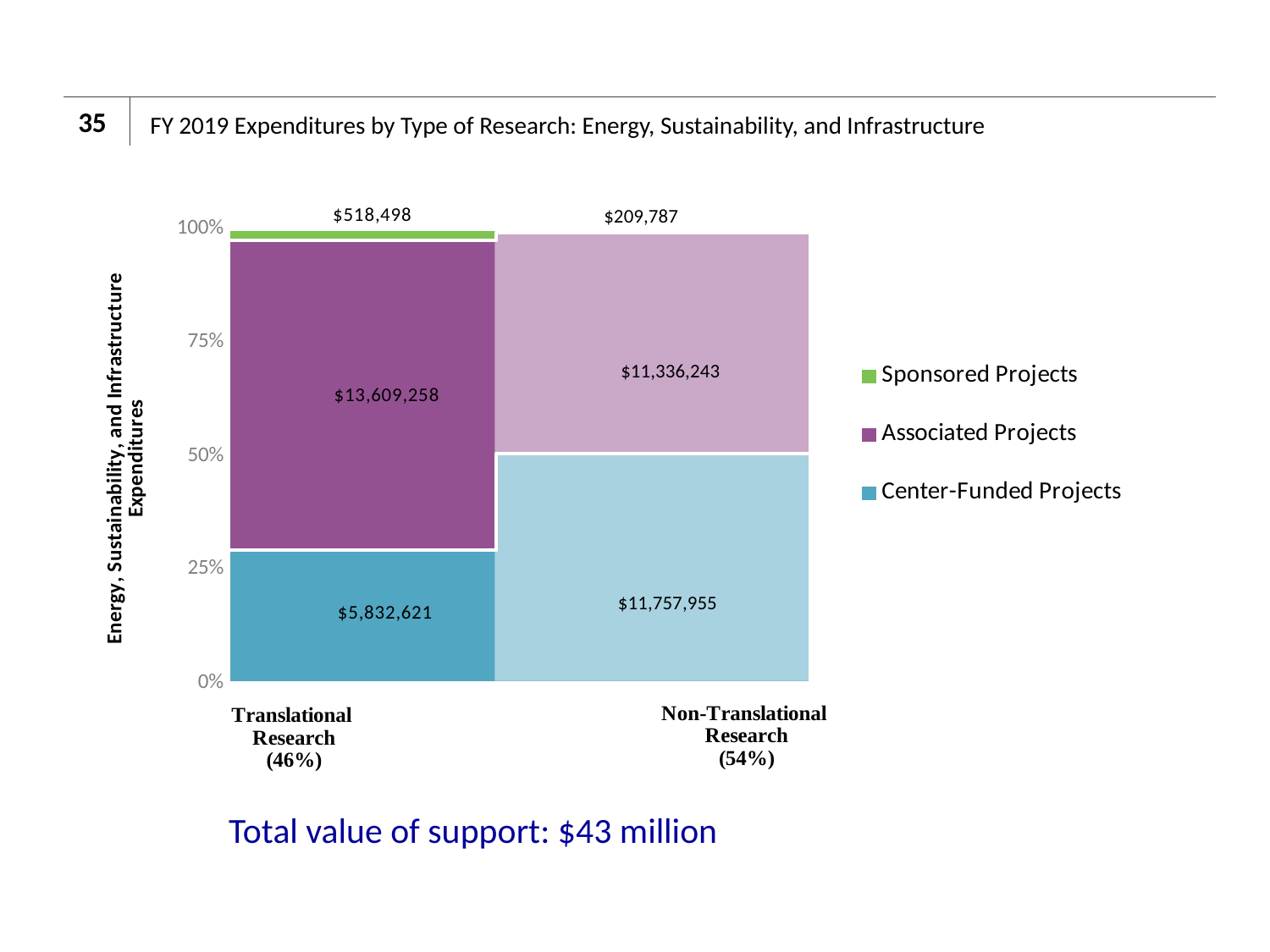
What is the difference between Center-Funded Projects for Non-Translational Research and for Translational Research? $5,925,334 Which series has the smallest value within the Non-Translational Research bar? Sponsored Projects How many categories are shown on the x axis? 2 Which is larger: Associated Projects for Translational Research or Associated Projects for Non-Translational Research? Translational Research How many series does the legend list? 3 What is the value of Sponsored Projects for Translational Research? $518,498 What is the value of Sponsored Projects for Non-Translational Research? $209,787 Which series has the largest value within the Translational Research bar? Associated Projects What is the total of the Non-Translational Research bar in dollars? $23,303,985 Is the Center-Funded Projects segment of the Translational Research bar greater or less than 50% of the bar? less What is the value of Center-Funded Projects for Non-Translational Research? $11,757,955 What is the value of Associated Projects for Translational Research? $13,609,258